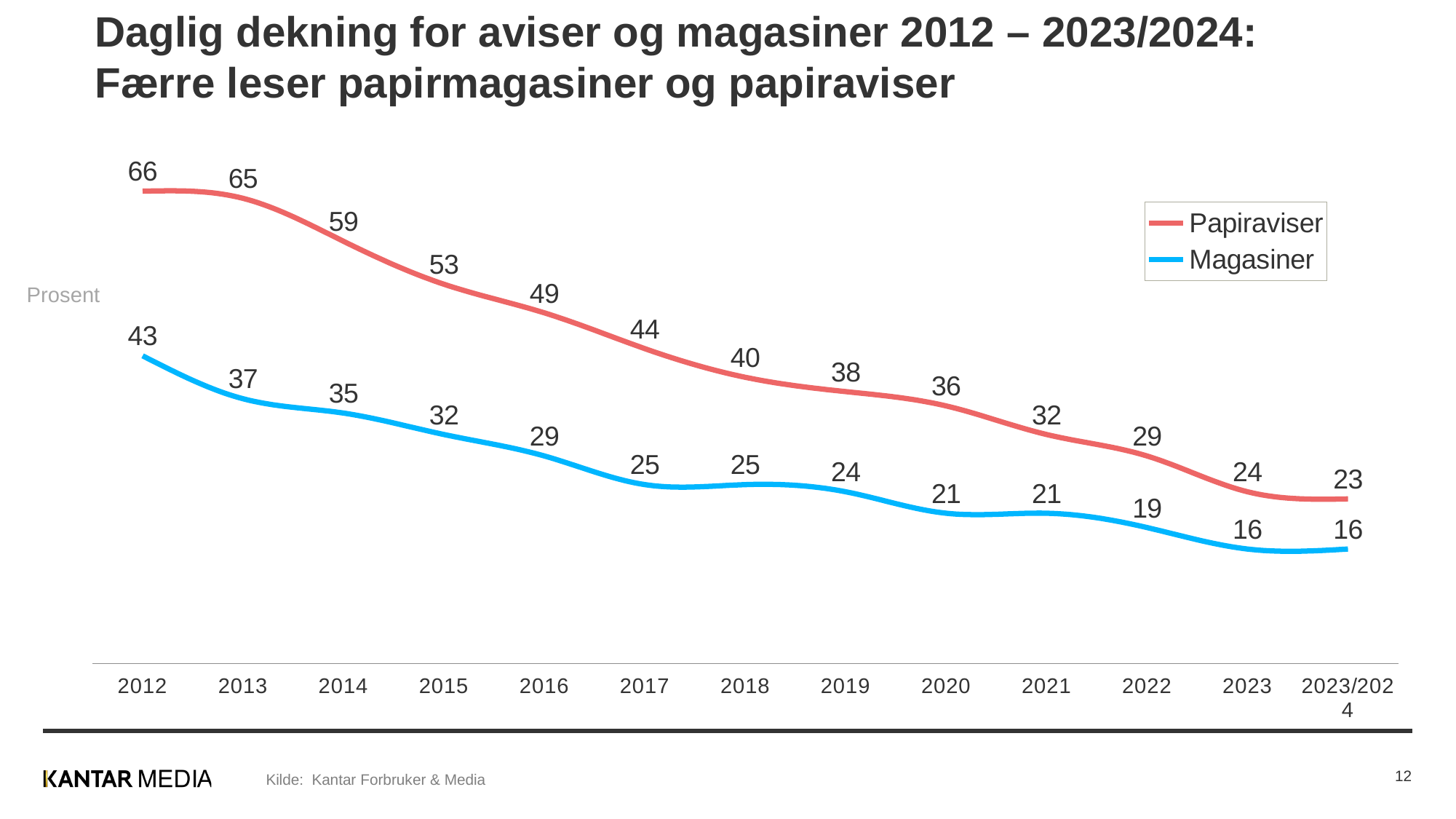
What is the value for Papiraviser in 2012? 66 Do the Papiraviser values rise or fall from 2012 to 2023/2024? Fall What is the value for Magasiner in 2020? 21 What is the value for Magasiner in 2016? 29 Which series has the larger value in 2015, Papiraviser or Magasiner? Papiraviser In which year is the Papiraviser value highest? 2012 What kind of chart is shown on the slide? Line chart What is the difference between Papiraviser and Magasiner in 2018? 15 What is the value for Papiraviser in 2023/2024? 23 How many series does the legend list? 2 What is the lowest value shown for Magasiner? 16 How many time points are shown on the x axis? 13